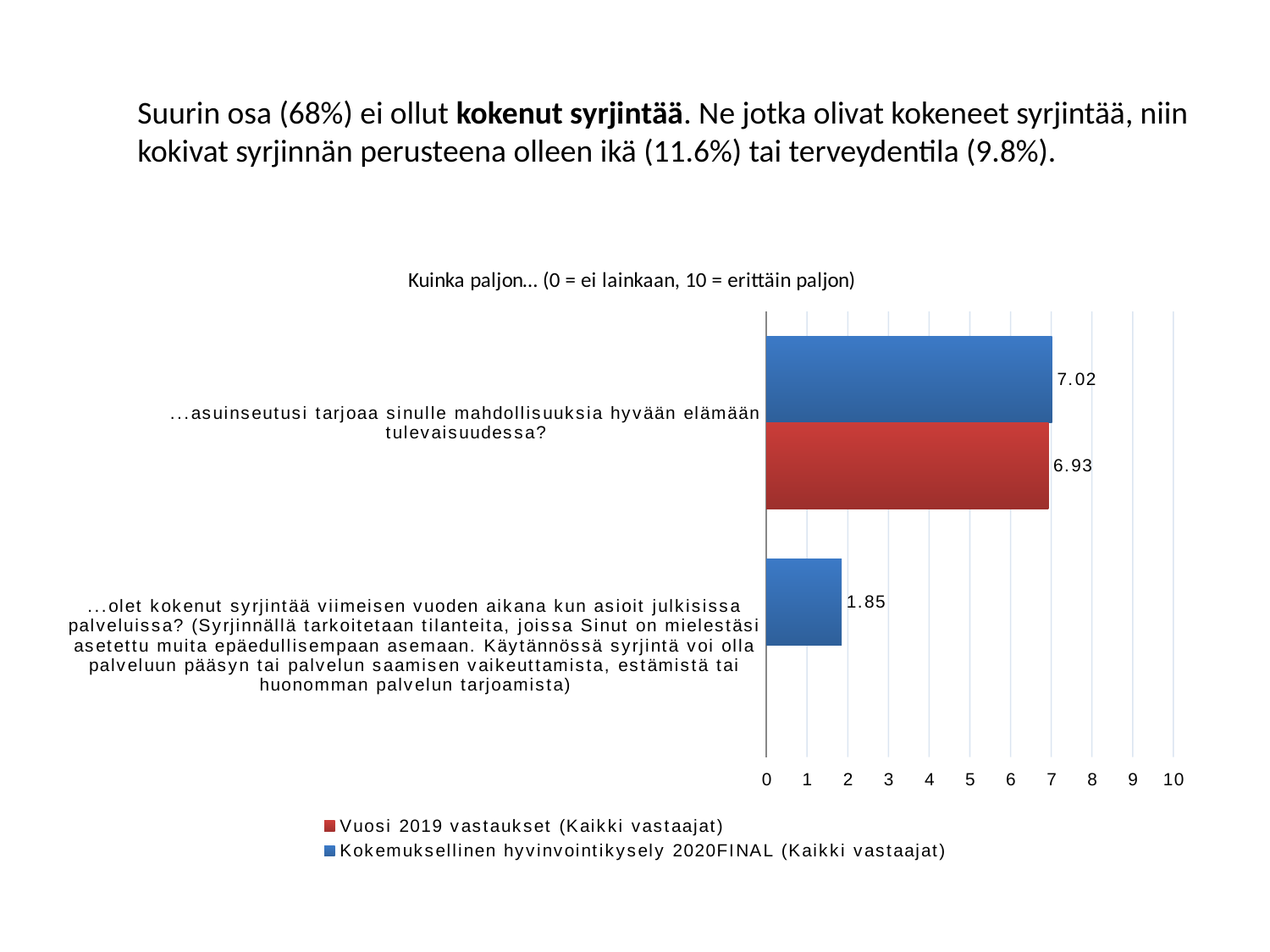
Which of the two questions has the lowest 2020 value? ...olet kokenut syrjintää viimeisen vuoden aikana kun asioit julkisissa palveluissa? What is the 2020 (Kokemuksellinen hyvinvointikysely 2020FINAL) value for "...asuinseutusi tarjoaa sinulle mahdollisuuksia hyvään elämään tulevaisuudessa?"? 7.02 What is the Vuosi 2019 vastaukset value for "...asuinseutusi tarjoaa sinulle mahdollisuuksia hyvään elämään tulevaisuudessa?"? 6.93 Which of the two questions has the higher 2020 value? ...asuinseutusi tarjoaa sinulle mahdollisuuksia hyvään elämään tulevaisuudessa? What is the 2020 (Kokemuksellinen hyvinvointikysely 2020FINAL) value for the question about having experienced discrimination ("...olet kokenut syrjintää viimeisen vuoden aikana...")? 1.85 What is the difference between the 2020 value (7.02) and the 2019 value (6.93) for "...asuinseutusi tarjoaa sinulle mahdollisuuksia hyvään elämään tulevaisuudessa?"? 0.09 What is the title of the chart? Kuinka paljon… (0 = ei lainkaan, 10 = erittäin paljon) For "...asuinseutusi tarjoaa sinulle mahdollisuuksia hyvään elämään tulevaisuudessa?", which is larger: the 2019 value or the 2020 value? The 2020 value (7.02) How many series does the chart legend list? 2 Is the 2020 value for the discrimination question ("...olet kokenut syrjintää...") greater or less than 2? less How many question categories are shown on the chart? 2 What type of chart is shown on the slide? Bar chart